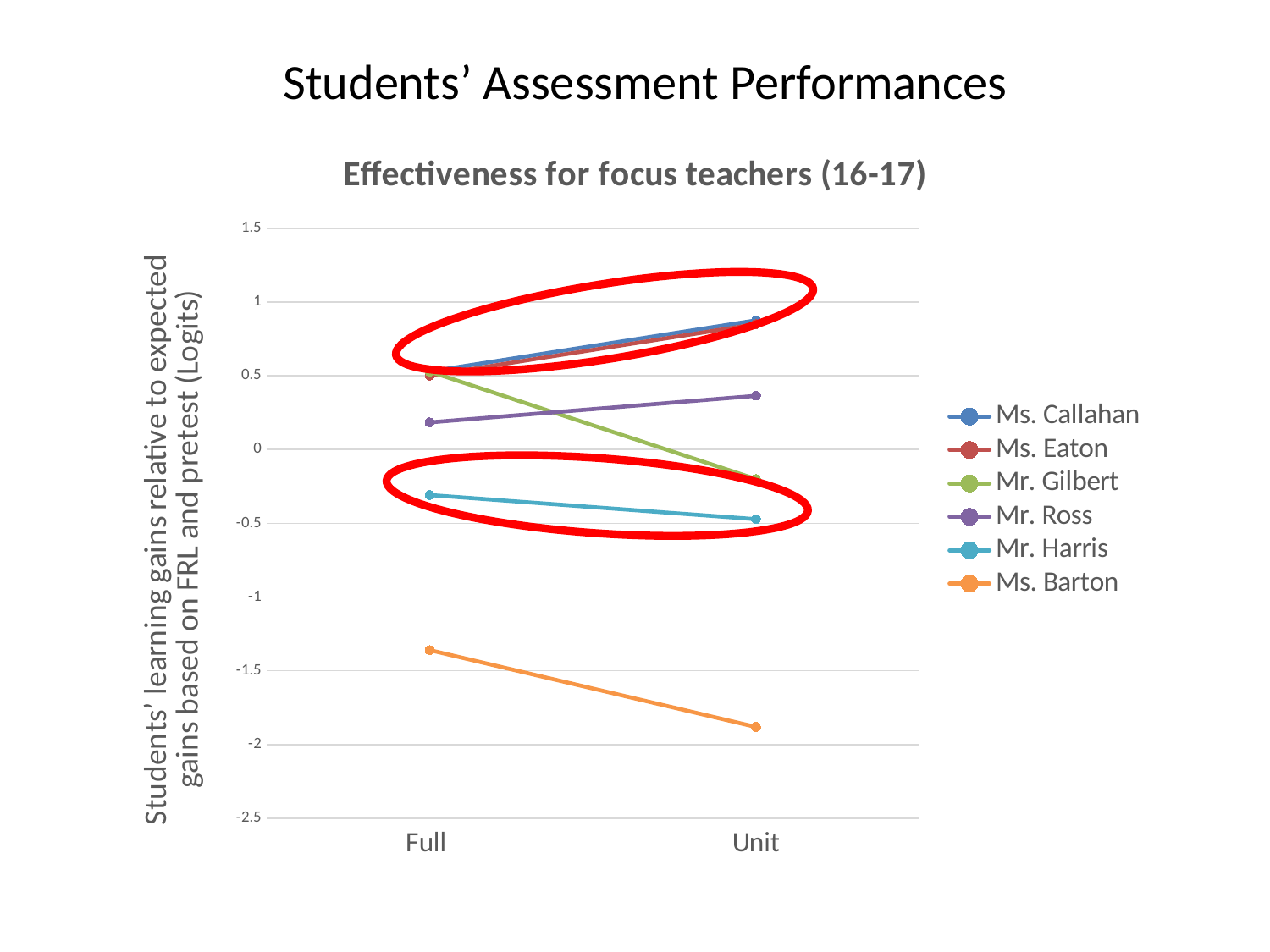
At Unit, which is larger: the value for Mr. Ross or the value for Mr. Gilbert? Mr. Ross What kind of chart is shown on the slide? line chart Is the value for Ms. Barton at Full greater or less than -1? less Which series is drawn in orange? Ms. Barton Does the value for Mr. Ross rise or fall from Full to Unit? rise What is the title of the chart? Effectiveness for focus teachers (16-17) How many series does the legend list? 6 How many categories are shown on the x axis? 2 Does the value for Mr. Gilbert rise or fall from Full to Unit? fall Which teacher has the lowest value at Unit? Ms. Barton Is the value for Mr. Ross at Unit greater or less than 0.5? less Does the value for Ms. Barton rise or fall from Full to Unit? fall